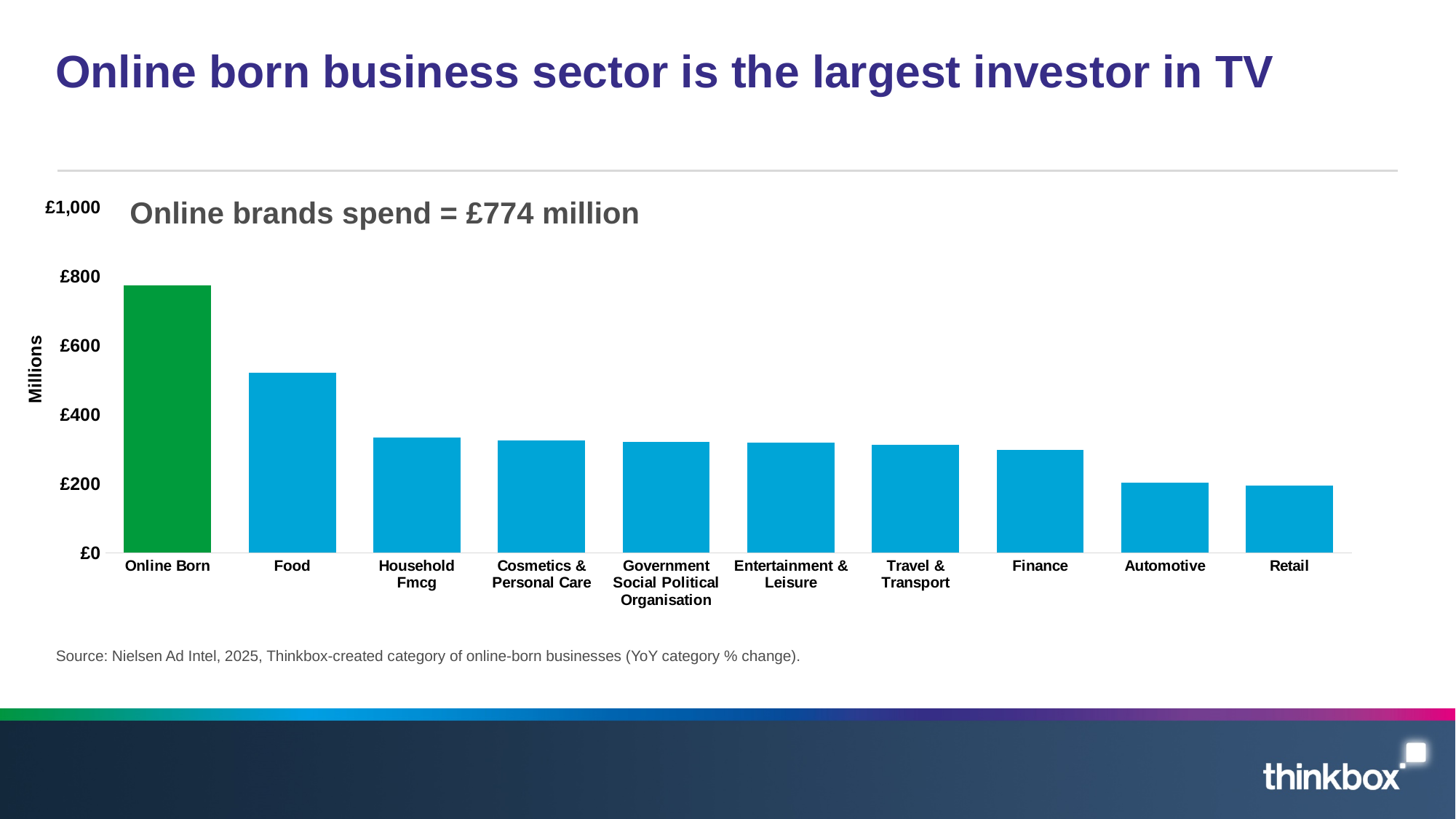
Which has a higher value, Food or Household Fmcg? Food What kind of chart is shown on the slide? bar chart What is the label on the y axis of the chart? Millions How many business sectors are shown on the x axis of the chart? 10 Is the value for Food greater or less than £400? greater According to the text on the chart, what is the spend of online brands? £774 million What colour is the Online Born bar? green Is the value for Food greater or less than £600? less Do the bar values generally rise or fall from left to right along the x axis? fall Is the value for Household Fmcg greater or less than £400? less Which sector has the highest TV spend in the chart? Online Born